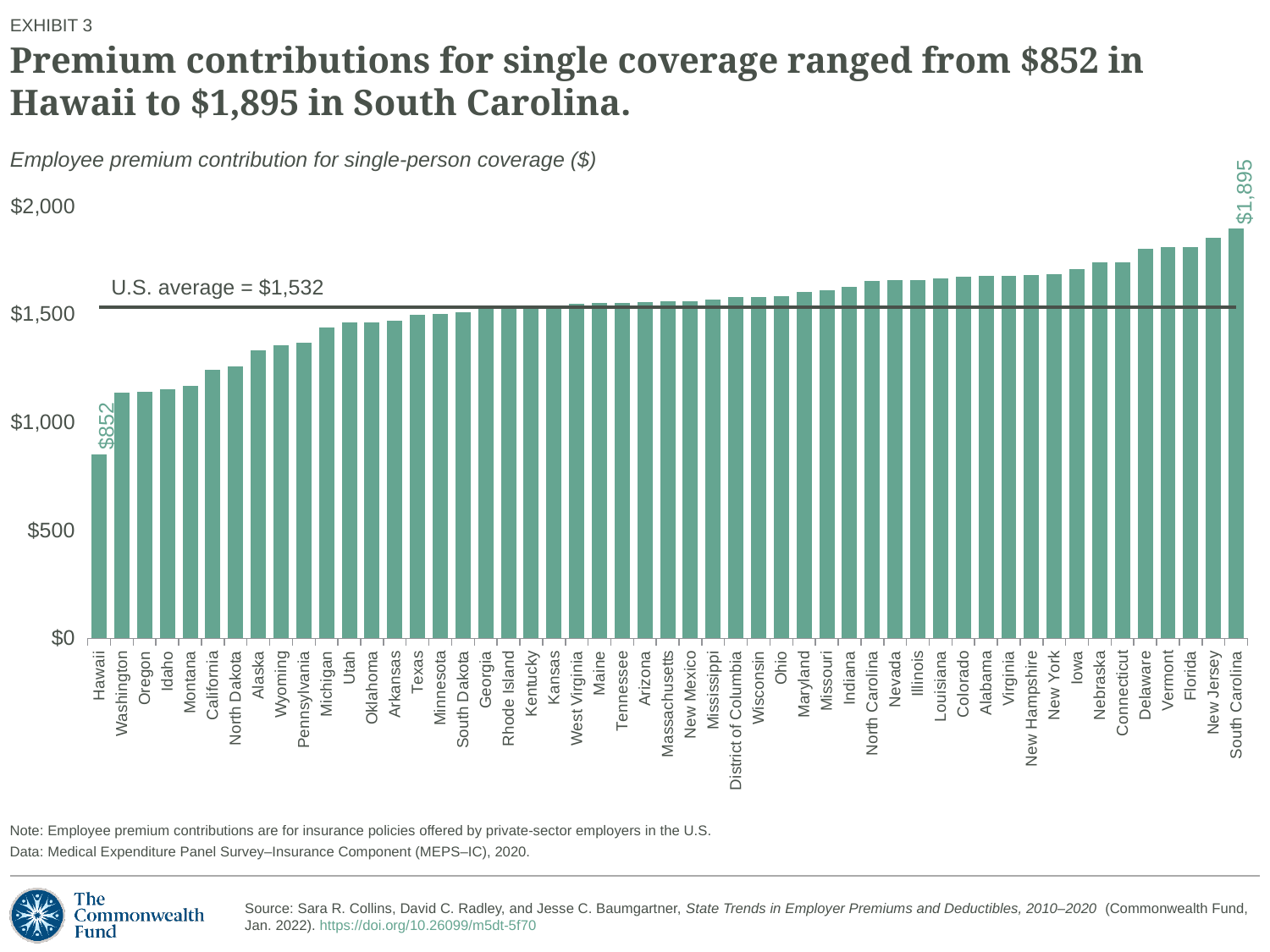
How many states and territories are shown on the chart? 51 Is the value for Alaska greater or less than $1,000? greater Is the value for Washington greater or less than $1,500? less Which state has the highest employee premium contribution for single-person coverage? South Carolina What is the employee premium contribution for single-person coverage in South Carolina? $1,895 Which has a larger employee premium contribution, Florida or Oregon? Florida What is the employee premium contribution for single-person coverage in Hawaii? $852 Is the value for New Jersey greater or less than $1,500? greater What is the difference between the employee premium contribution in South Carolina and in Hawaii? $1,043 What is the U.S. average employee premium contribution shown on the chart? $1,532 What kind of chart is shown on the slide? Bar chart Which state has the lowest employee premium contribution for single-person coverage? Hawaii